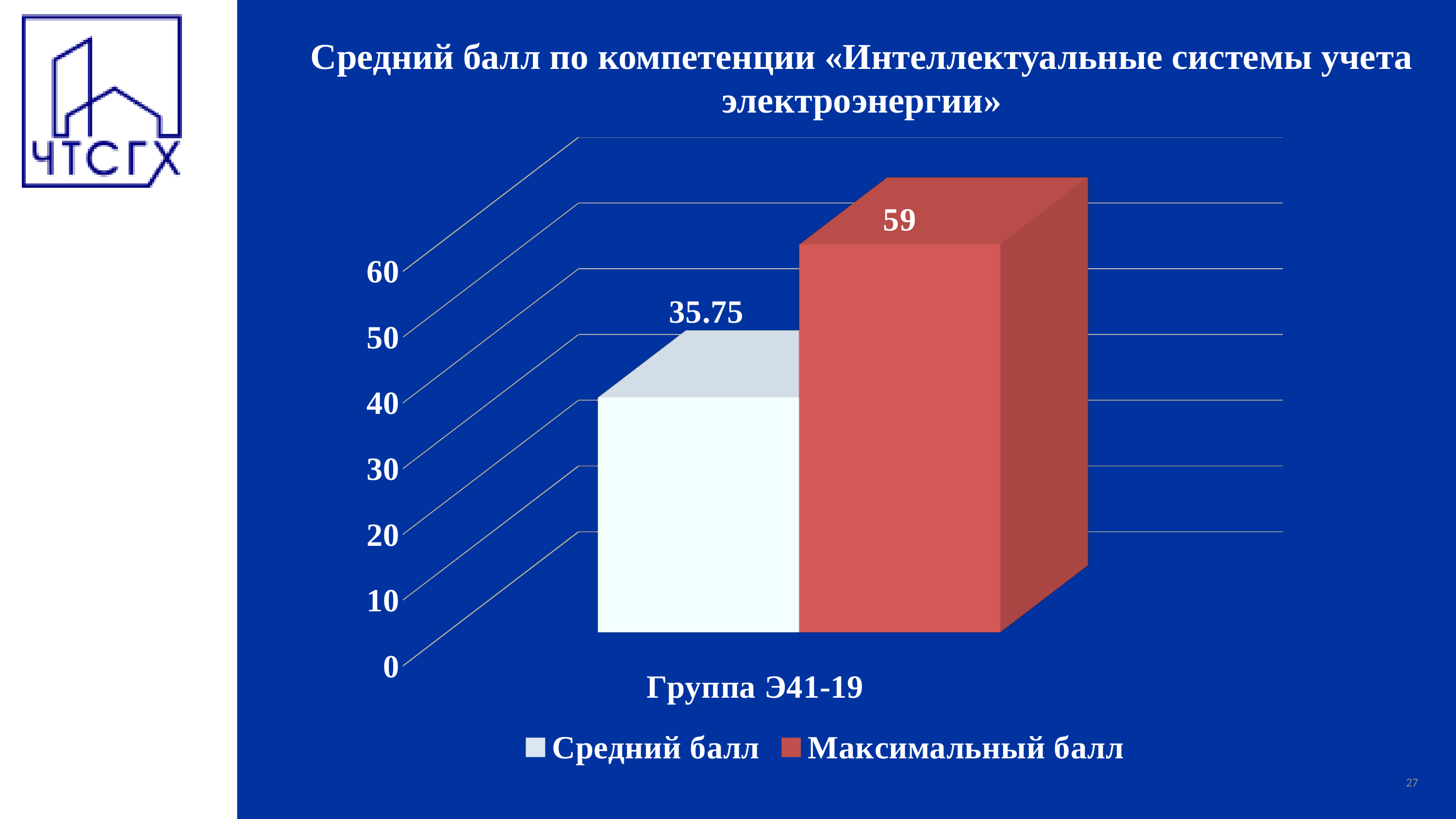
Is the value of Средний балл for Группа Э41-19 greater or less than 40? less Which series has the higher value for Группа Э41-19, Средний балл or Максимальный балл? Максимальный балл What is the title of the chart? Средний балл по компетенции «Интеллектуальные системы учета электроэнергии» Is the value of Максимальный балл for Группа Э41-19 greater or less than 50? greater What kind of chart is shown on the slide? bar chart What is the name of the category shown on the x axis? Группа Э41-19 What colour are the bars for the Максимальный балл series? red How many series does the legend list? 2 How many categories are shown on the x axis? 1 What is the difference between Максимальный балл and Средний балл for Группа Э41-19? 23.25 What is the value of Средний балл for Группа Э41-19? 35.75 What is the value of Максимальный балл for Группа Э41-19? 59